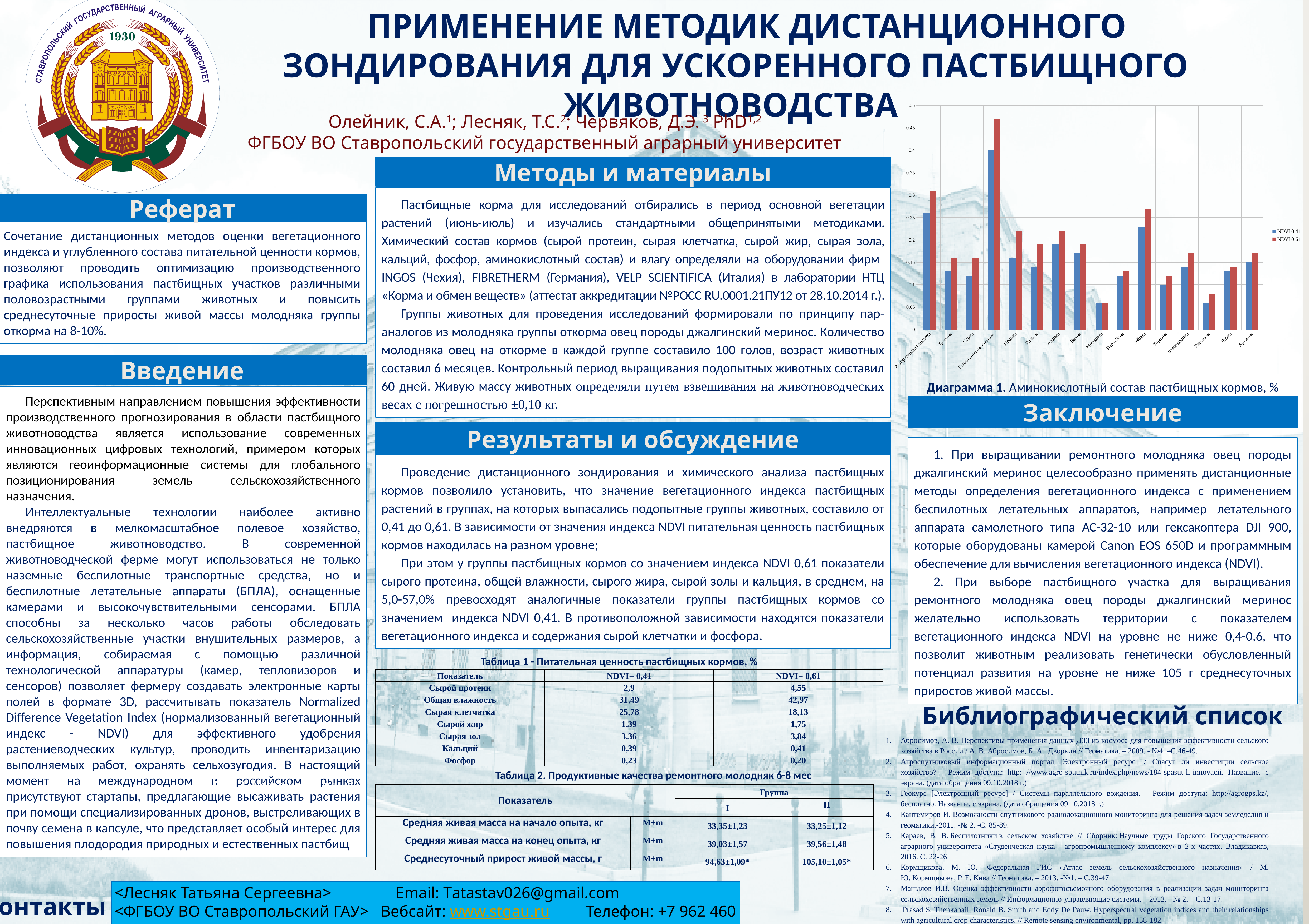
What kind of chart is Диаграмма 1 on the slide? bar chart In Диаграмма 1, which amino acid has the highest value for the NDVI 0,61 series? Глютаминовая кислота In Диаграмма 1, is the NDVI 0,61 value for Метионин greater or less than 0.1? less How many amino acid categories are shown along the x axis of Диаграмма 1? 16 In Диаграмма 1, which amino acid has the highest value for the NDVI 0,41 series? Глютаминовая кислота In Диаграмма 1, is the NDVI 0,41 value for Аспарагиновая кислота greater or less than 0.2? greater In Диаграмма 1, for Глютаминовая кислота, which series has the larger value: NDVI 0,41 or NDVI 0,61? NDVI 0,61 In Диаграмма 1, is the NDVI 0,41 value for Пролин greater or less than 0.2? less In Диаграмма 1, for the NDVI 0,41 series, which is larger: Аспарагиновая кислота or Треонин? Аспарагиновая кислота How many series does the legend of Диаграмма 1 list? 2 What are the two legend entries in Диаграмма 1? NDVI 0,41 and NDVI 0,61